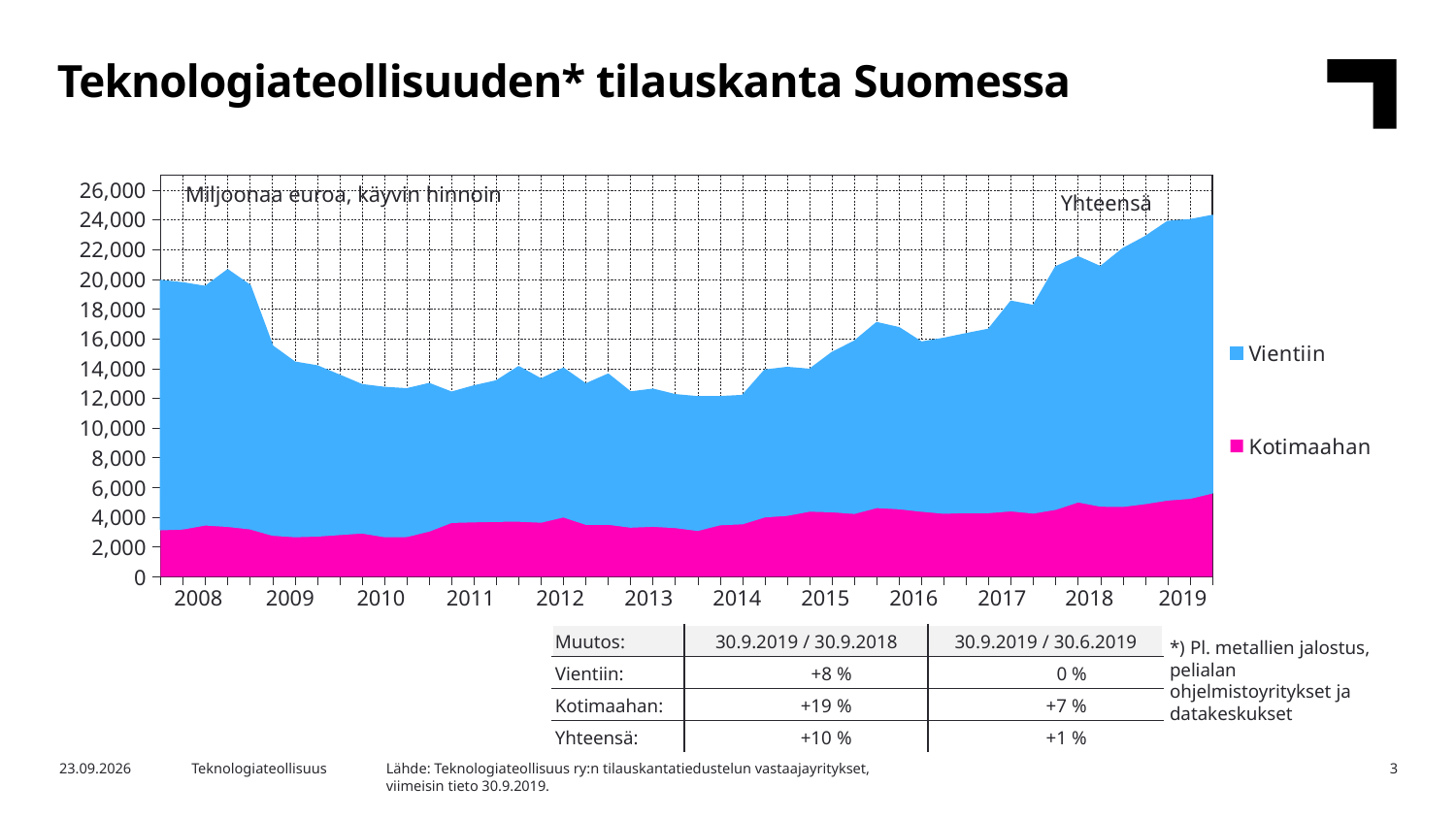
Does the total order book (Yhteensä) rise or fall from 2016 to 2019? rise What are the two series named in the chart legend? Vientiin and Kotimaahan How many year labels are shown on the x axis of the chart? 12 Is the total (Yhteensä) value at the end of 2019 greater or less than 22,000? greater Does the total order book (Yhteensä) rise or fall from 2008 to 2009? fall What kind of chart is shown on the slide? Stacked area chart Is the Kotimaahan value in 2010 greater or less than 4,000? less Is the total (Yhteensä) value in 2013 greater or less than 14,000? less Which series is larger throughout the chart, Vientiin or Kotimaahan? Vientiin What unit label is printed inside the chart area? Miljoonaa euroa, käyvin hinnoin How many series does the chart legend list? 2